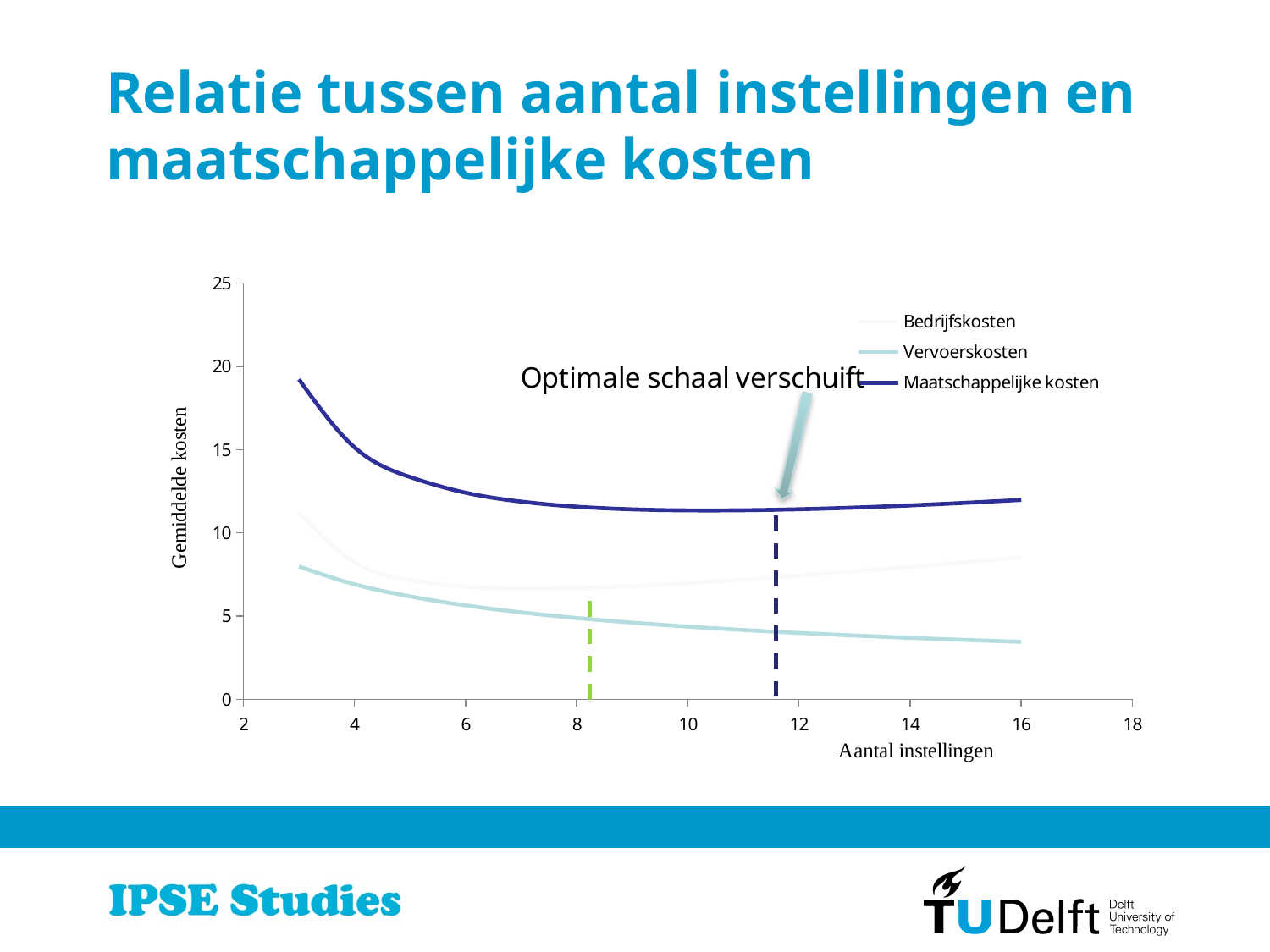
Do the values of Vervoerskosten rise or fall as Aantal instellingen increases? fall What kind of chart is shown on the slide? line chart Which series has the highest values across the chart? Maatschappelijke kosten Which series are listed in the legend? Bedrijfskosten, Vervoerskosten, Maatschappelijke kosten Is the value of Maatschappelijke kosten at 3 instellingen greater or less than 15? greater At 10 instellingen, which is larger: Maatschappelijke kosten or Vervoerskosten? Maatschappelijke kosten What is the label of the x axis? Aantal instellingen How many series does the legend list? 3 Is the value of Maatschappelijke kosten at 10 instellingen greater or less than 15? less What is the highest value shown on the y axis? 25 Is the value of Vervoerskosten at 16 instellingen greater or less than 5? less